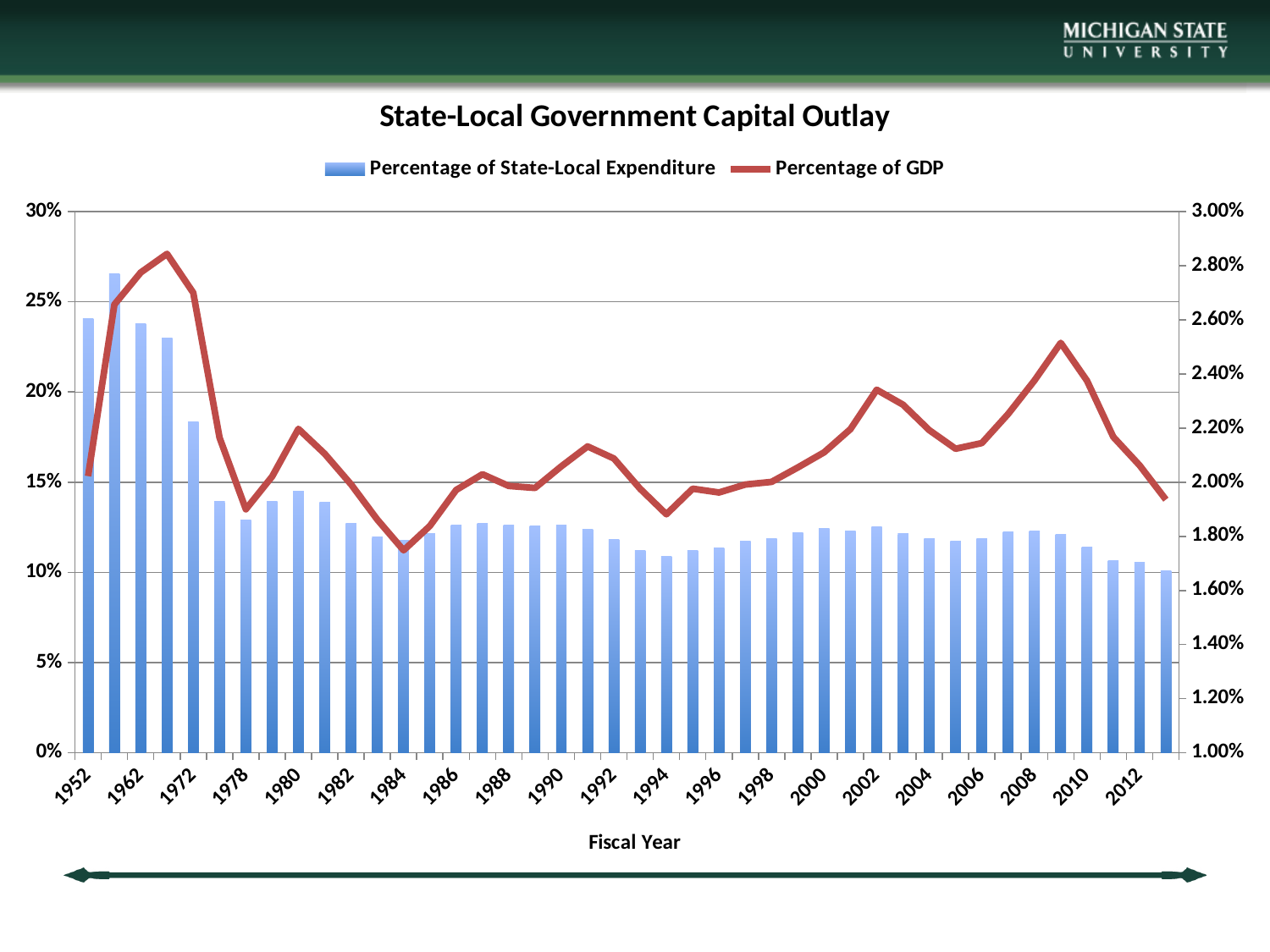
Does the Percentage of State-Local Expenditure rise or fall from 1952 to 1978? fall Which labeled fiscal year has the lowest Percentage of GDP? 1984 What is the title of the chart? State-Local Government Capital Outlay Is the Percentage of State-Local Expenditure for 2012 greater or less than 15%? less Is the Percentage of State-Local Expenditure for 1952 greater or less than 20%? greater Is the Percentage of State-Local Expenditure for 1972 greater or less than 15%? greater What is the title of the x axis? Fiscal Year How many series does the legend list? 2 What type of chart is used to show Percentage of State-Local Expenditure? bar chart Which is larger, the Percentage of State-Local Expenditure in 1952 or in 2012? 1952